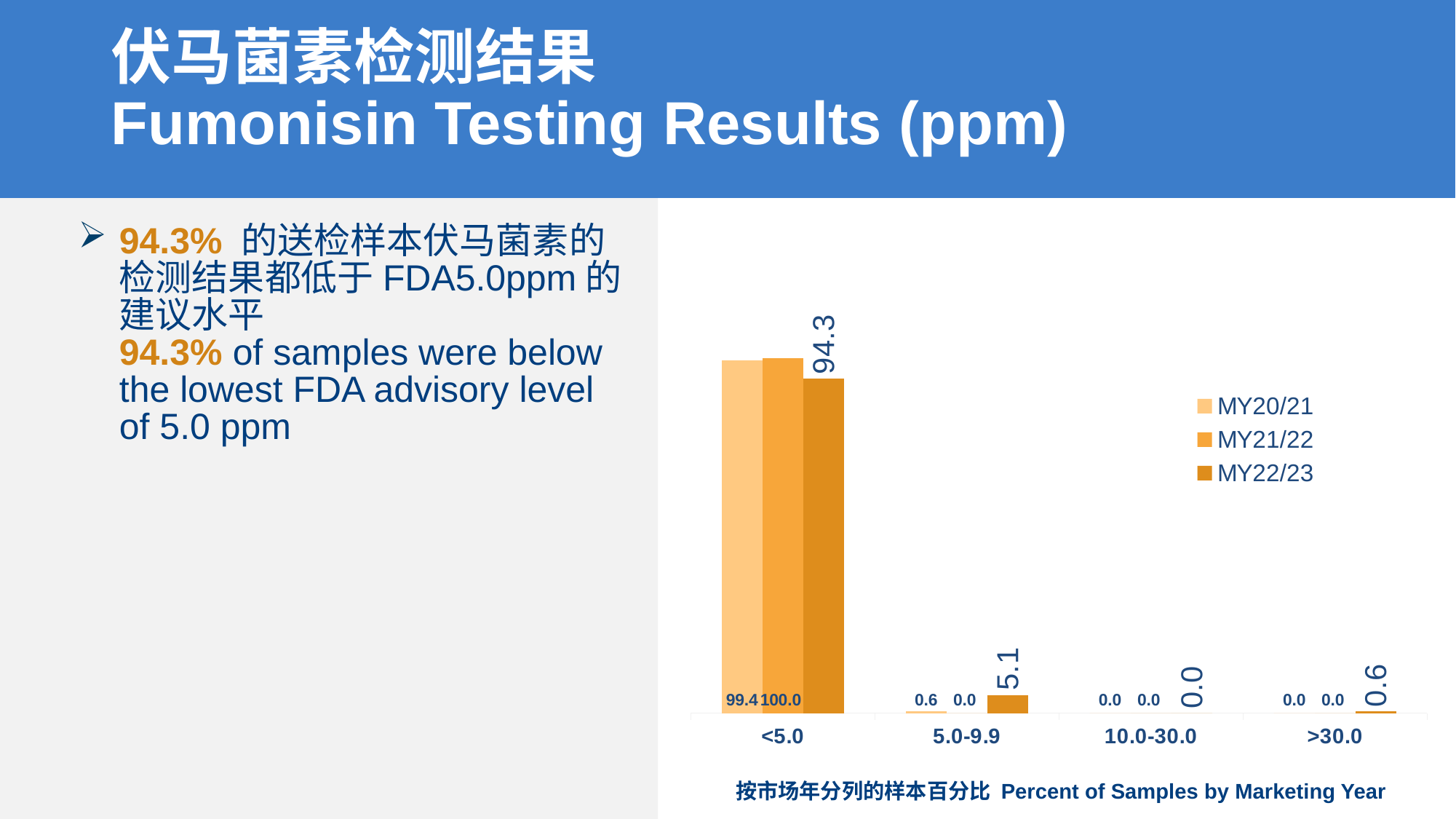
What kind of chart is shown on the slide? bar chart What is the value for MY22/23 in the <5.0 category? 94.3 Which is larger in the 5.0-9.9 category, the value for MY20/21 or the value for MY22/23? MY22/23 What is the value for MY20/21 in the <5.0 category? 99.4 How many series does the chart legend list? 3 What is the difference between the MY21/22 and MY22/23 values in the <5.0 category? 5.7 What is the x-axis title of the chart? 按市场年分列的样本百分比 Percent of Samples by Marketing Year How many categories are shown on the x axis of the chart? 4 What is the value for MY22/23 in the >30.0 category? 0.6 What is the value for MY21/22 in the <5.0 category? 100.0 Which series has the highest value in the <5.0 category? MY21/22 What is the value for MY22/23 in the 5.0-9.9 category? 5.1